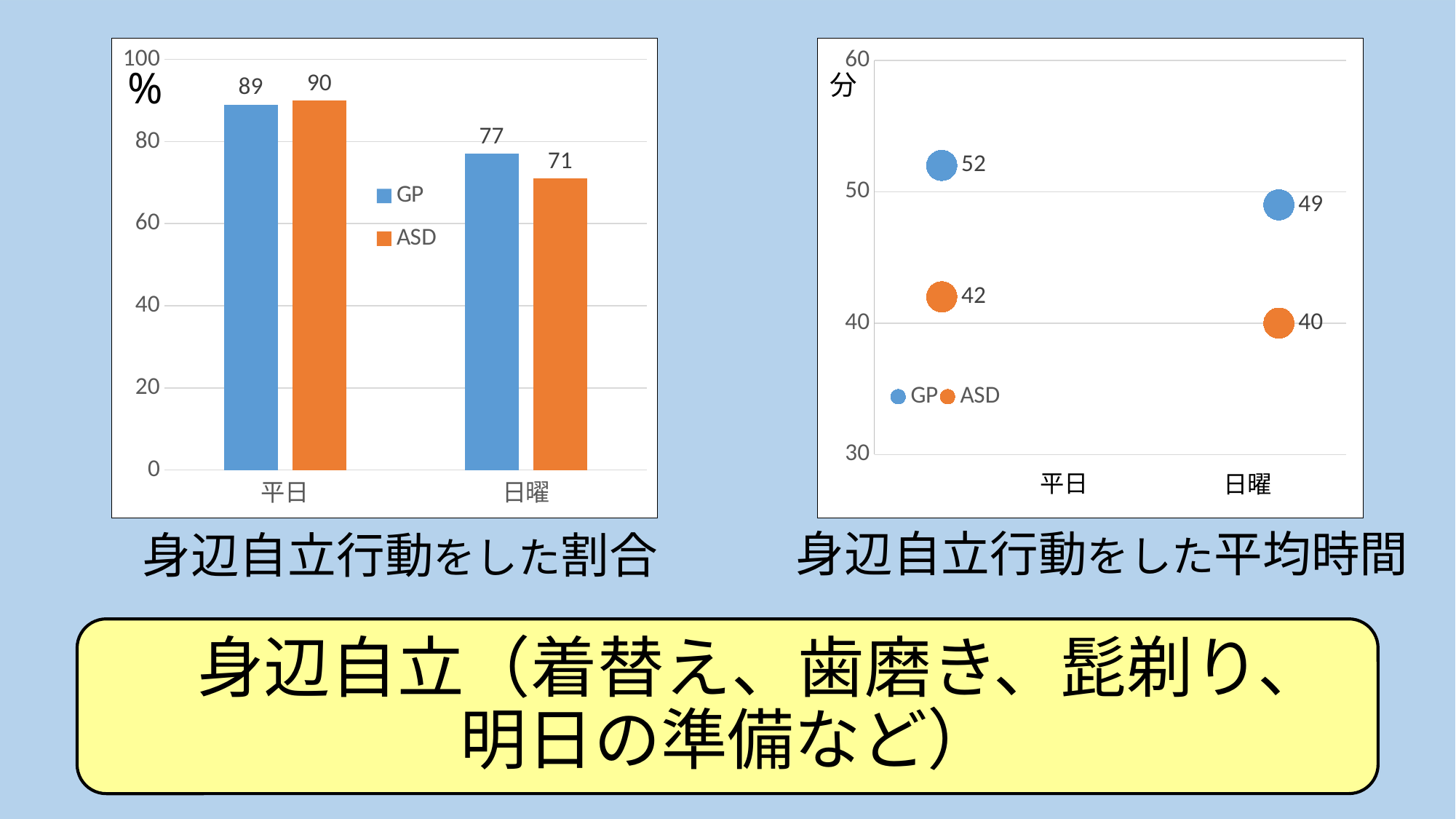
In the left chart (身辺自立行動をした割合), what is the value for ASD on 日曜? 71 In the right chart (身辺自立行動をした平均時間), what is the difference between GP and ASD on 平日? 10 In the left chart (身辺自立行動をした割合), what kind of chart is it? Bar chart In the right chart (身辺自立行動をした平均時間), what unit is shown on the y axis? 分 In the left chart (身辺自立行動をした割合), which is larger on 平日, GP or ASD? ASD In the left chart (身辺自立行動をした割合), what is the difference between GP and ASD on 日曜? 6 In the right chart (身辺自立行動をした平均時間), which series has the highest value? GP In the right chart (身辺自立行動をした平均時間), what is the value for ASD on 日曜? 40 In the left chart (身辺自立行動をした割合), what is the value for GP on 平日? 89 In the left chart (身辺自立行動をした割合), how many series does the legend list? 2 In the right chart (身辺自立行動をした平均時間), does the GP value fall or rise from 平日 to 日曜? Fall In the right chart (身辺自立行動をした平均時間), what is the value for GP on 平日? 52